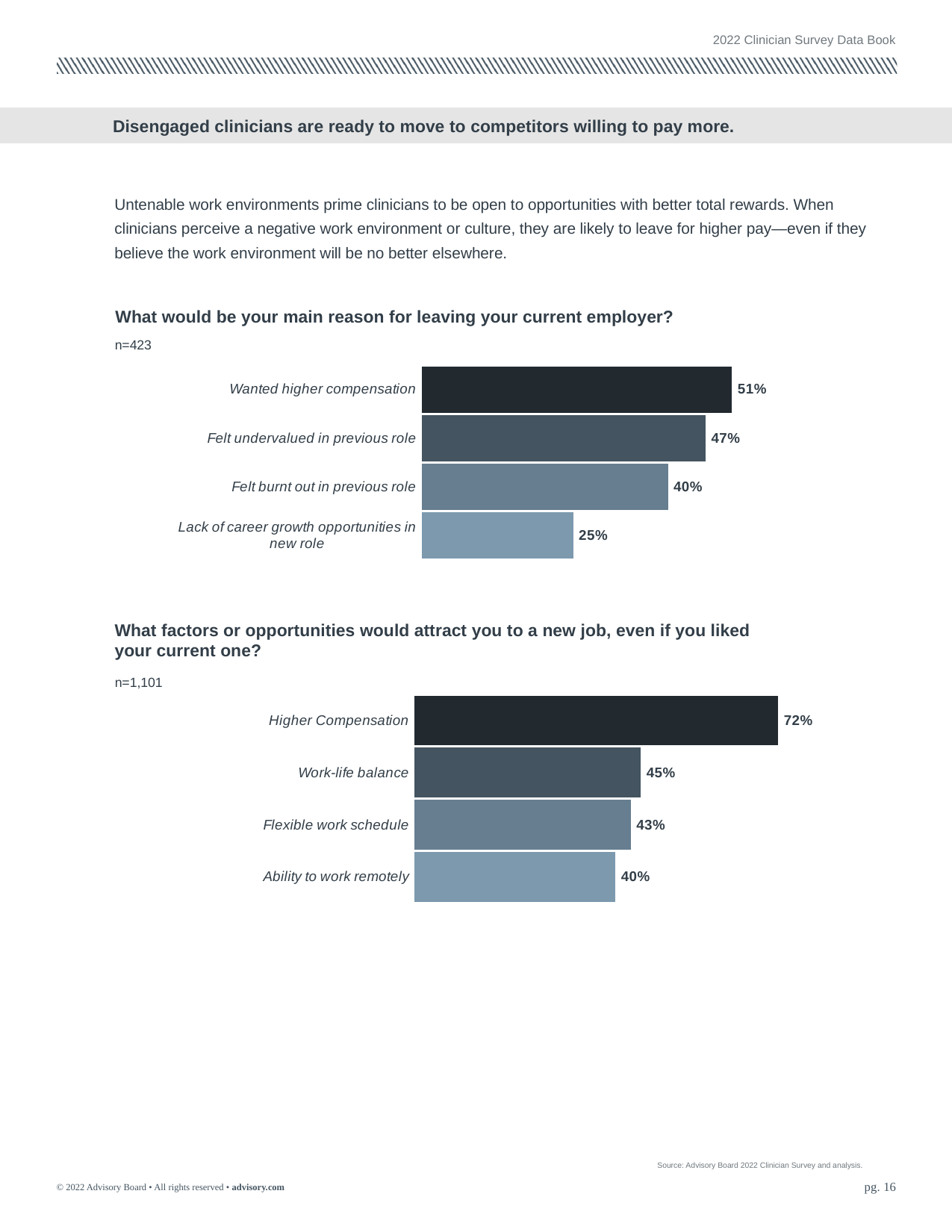
In the chart 'What would be your main reason for leaving your current employer?', how many categories are shown? 4 In the chart 'What would be your main reason for leaving your current employer?', what is the sample size shown? n=423 In the chart 'What factors or opportunities would attract you to a new job, even if you liked your current one?', what is the value for 'Higher Compensation'? 72% In the chart 'What factors or opportunities would attract you to a new job, even if you liked your current one?', what is the difference between 'Higher Compensation' and 'Work-life balance'? 27% What kind of chart is the bottom chart on the slide? Bar chart In the chart 'What factors or opportunities would attract you to a new job, even if you liked your current one?', what is the value for 'Ability to work remotely'? 40% In the chart 'What would be your main reason for leaving your current employer?', what is the value for 'Felt burnt out in previous role'? 40% In the chart 'What would be your main reason for leaving your current employer?', which category has the highest value? Wanted higher compensation In the chart 'What factors or opportunities would attract you to a new job, even if you liked your current one?', which is larger: 'Work-life balance' or 'Flexible work schedule'? Work-life balance In the chart 'What factors or opportunities would attract you to a new job, even if you liked your current one?', what is the sample size shown? n=1,101 In the chart 'What would be your main reason for leaving your current employer?', what is the difference between 'Wanted higher compensation' and 'Felt undervalued in previous role'? 4% In the chart 'What would be your main reason for leaving your current employer?', which category has the lowest value? Lack of career growth opportunities in new role